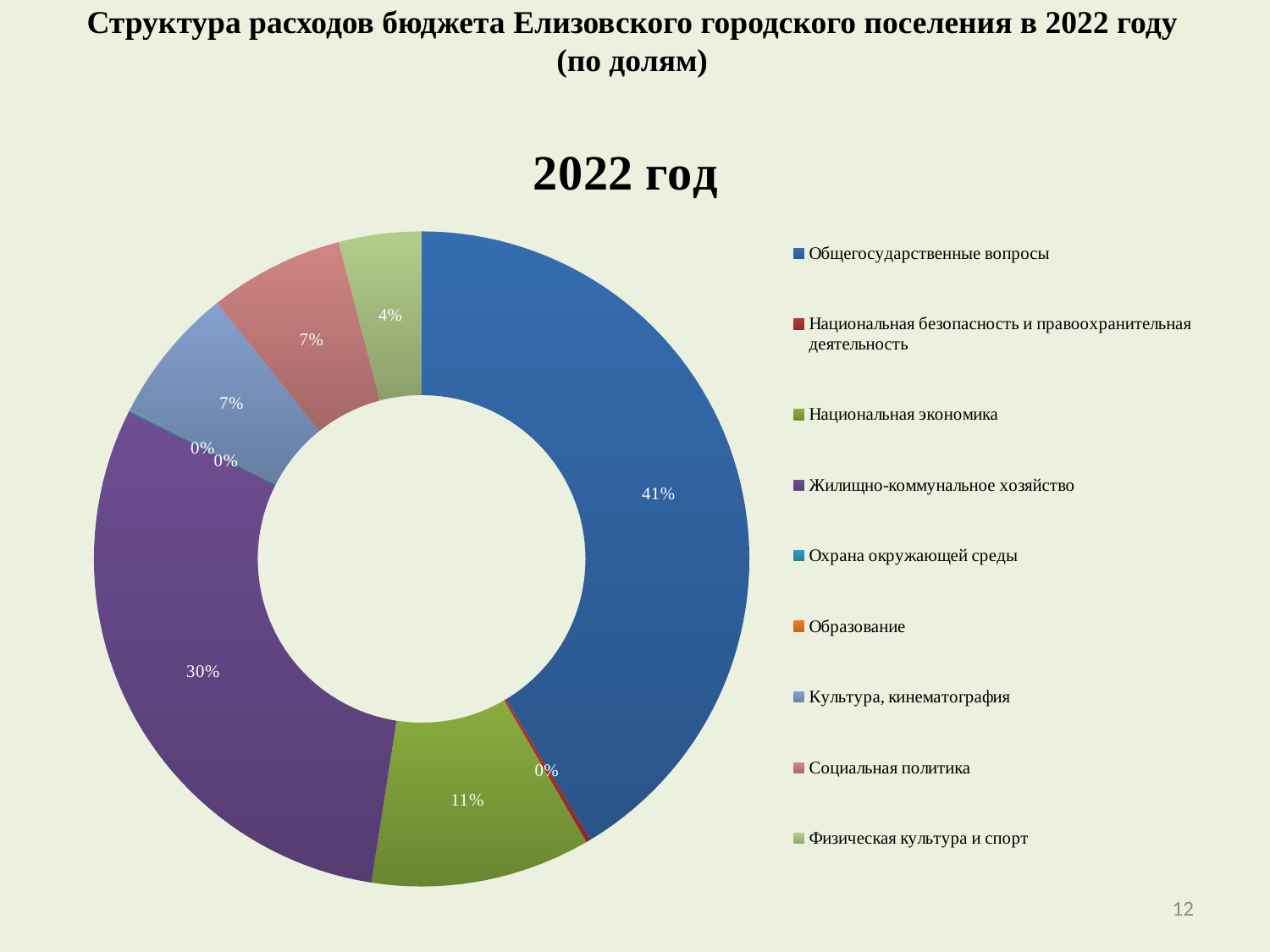
What is the difference in percentage points between the shares of Общегосударственные вопросы and Жилищно-коммунальное хозяйство? 11 What kind of chart is shown on the slide? Doughnut (pie) chart Which has a larger share: Национальная экономика or Физическая культура и спорт? Национальная экономика What share of the 2022 budget expenditure goes to Социальная политика? 7% What is the title shown directly above the chart? 2022 год How many expenditure categories does the legend list? 9 Which has a larger share: Жилищно-коммунальное хозяйство or Культура, кинематография? Жилищно-коммунальное хозяйство What share of the 2022 budget expenditure goes to Физическая культура и спорт? 4% What share of the 2022 budget expenditure goes to Национальная экономика? 11% Which expenditure category has the largest share in the 2022 chart? Общегосударственные вопросы What share of the 2022 budget expenditure goes to Жилищно-коммунальное хозяйство? 30% What share of the 2022 budget expenditure goes to Общегосударственные вопросы? 41%